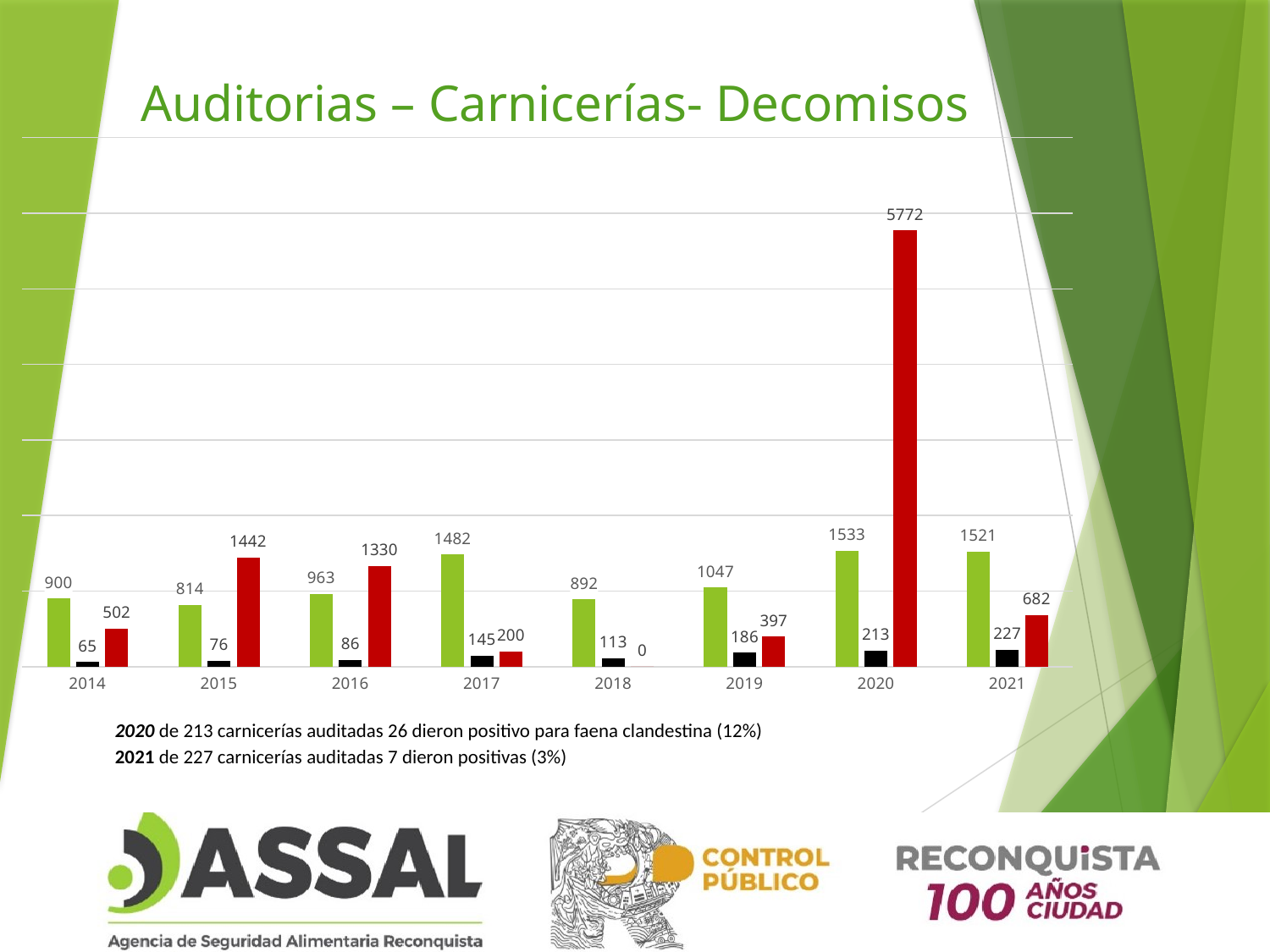
What is the value of the black bar for 2021? 227 In which year is the red bar highest? 2020 What is the value of the red bar for 2018? 0 In which year is the green bar highest? 2020 What is the title of the slide? Auditorias – Carnicerías- Decomisos How many years are shown on the x axis? 8 What is the value of the green bar for 2017? 1482 What is the difference between the green bar values for 2020 and 2021? 12 Which is larger in 2015, the green bar or the red bar? the red bar In which year is the black bar lowest? 2014 What kind of chart is shown on the slide? bar chart What is the value of the red bar for 2020? 5772